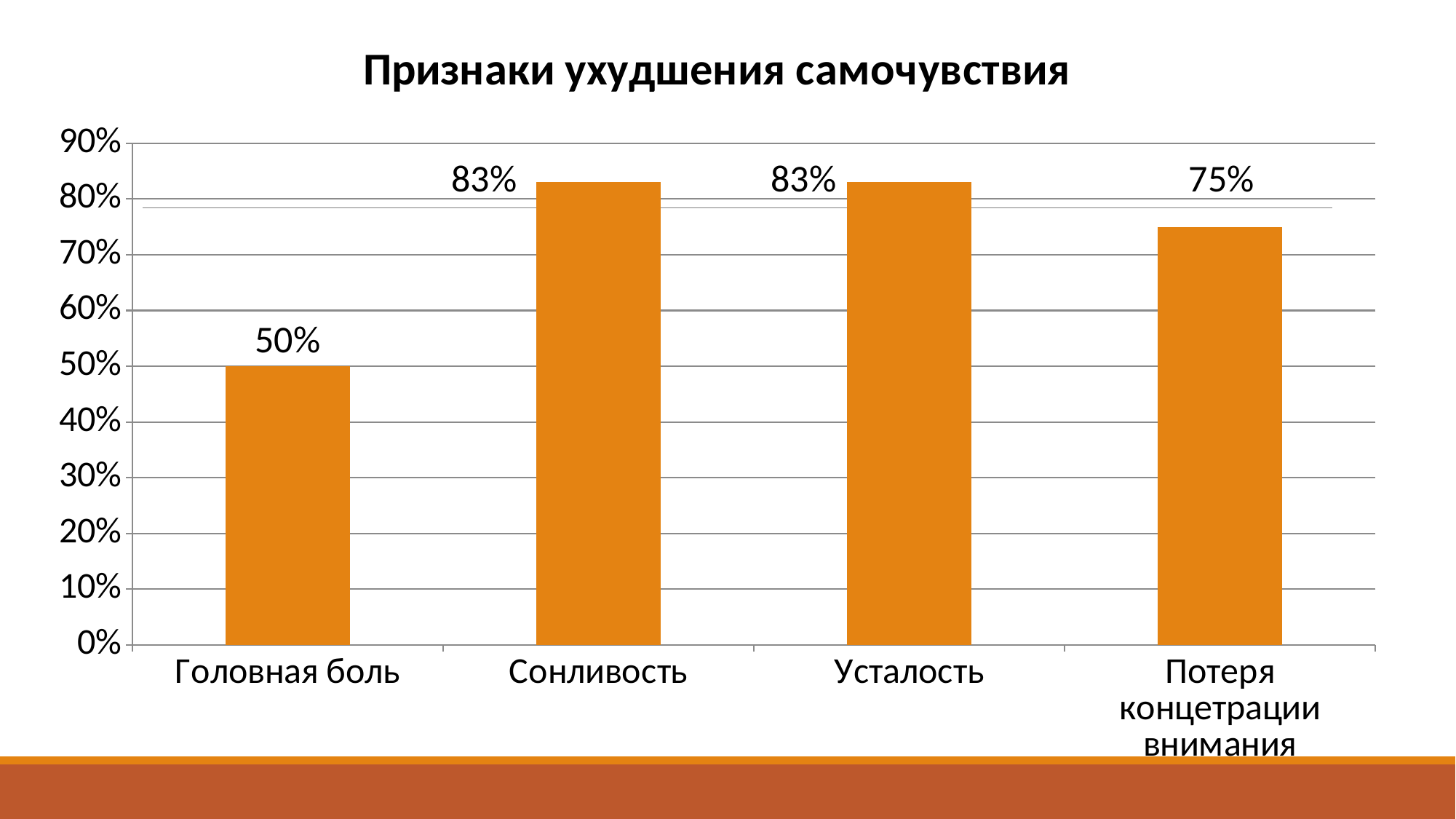
What is the difference between the values for Сонливость and Головная боль? 33% Which is larger, the value for Сонливость or the value for Потеря концетрации внимания? Сонливость How many categories are shown on the chart? 4 What kind of chart is shown on the slide? bar chart What is the value for Головная боль? 50% What is the value for Потеря концетрации внимания? 75% What is the value for Усталость? 83% Is the value for Потеря концетрации внимания greater or less than 70%? greater What is the title of the chart? Признаки ухудшения самочувствия What is the value for Сонливость? 83% Which category has the lowest value? Головная боль What is the difference between the values for Усталость and Потеря концетрации внимания? 8%